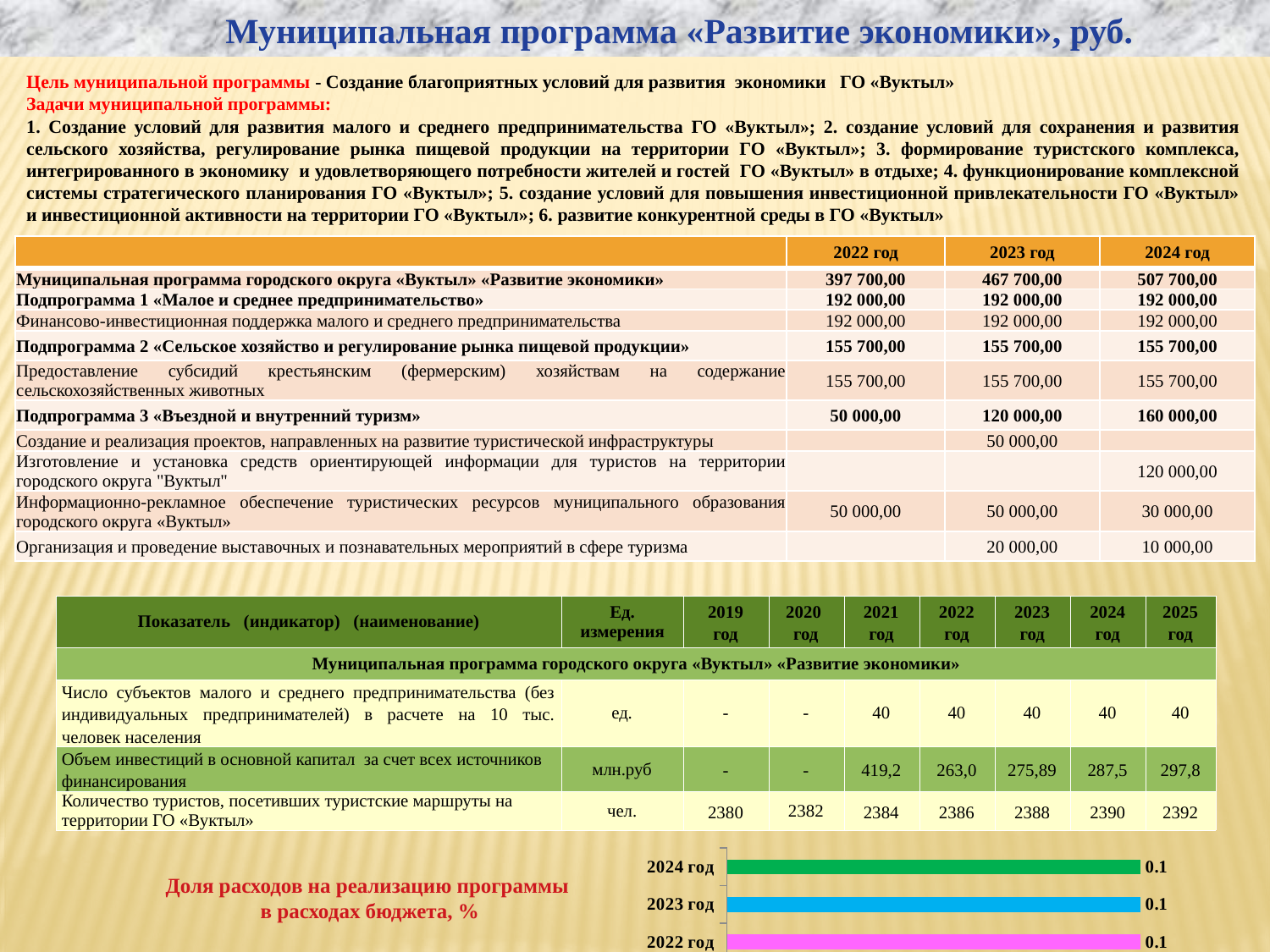
What is the value for 2022 год in the bar chart? 0.1 What is the title of the bar chart? Доля расходов на реализацию программы в расходах бюджета, % How many bars (categories) are shown in the bar chart? 3 What is the value for 2024 год in the bar chart? 0.1 What is the value for 2023 год in the bar chart? 0.1 Do the values in the bar chart rise, fall, or stay the same from 2022 год to 2024 год? stay the same What kind of chart is shown at the bottom of the slide? bar chart What colour is the bar for 2022 год in the bar chart? magenta (pink) What is the difference between the values for 2024 год and 2022 год in the bar chart? 0